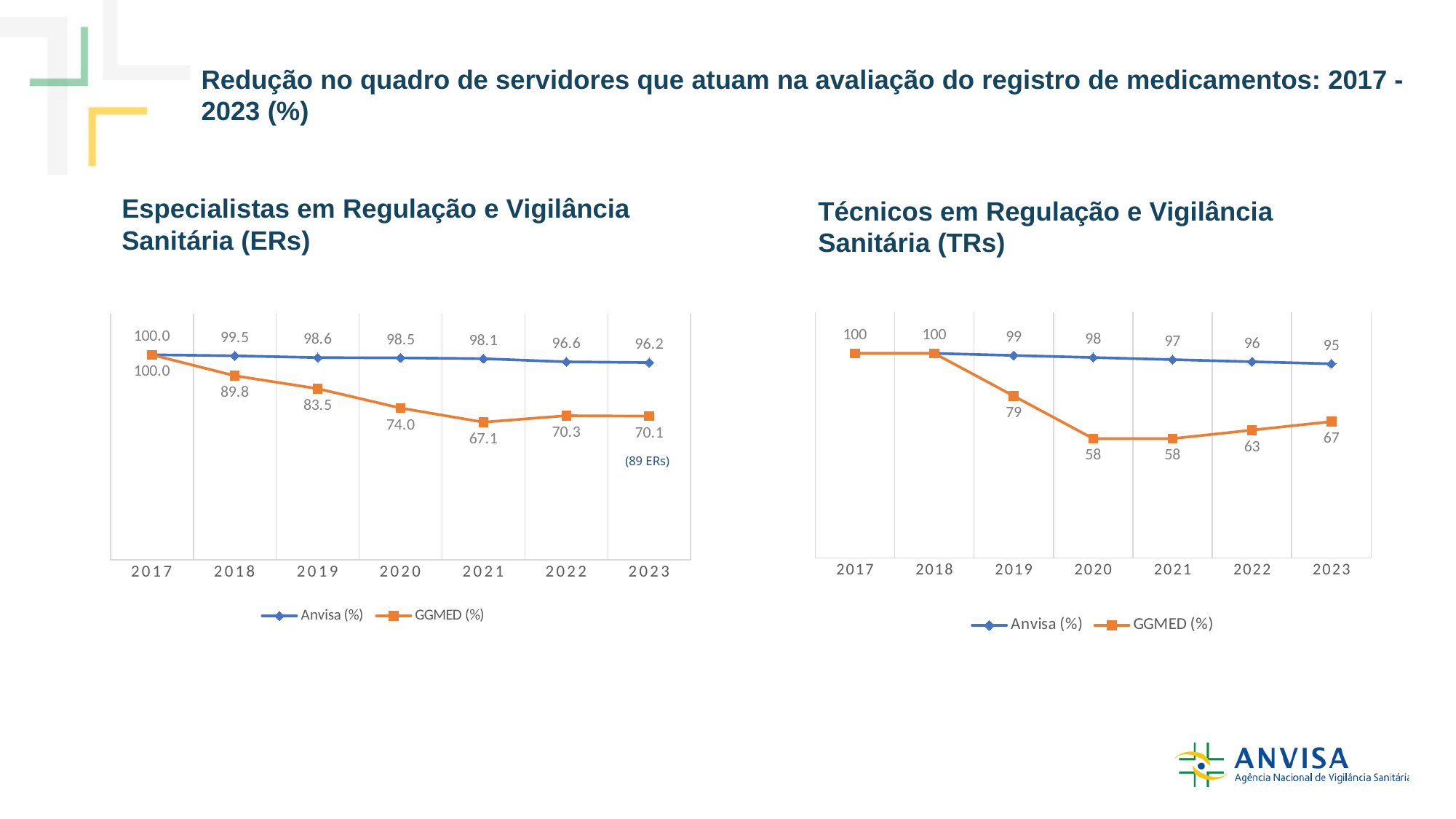
What kind of chart is the left chart (ERs)? Line chart In the right chart (Técnicos em Regulação e Vigilância Sanitária (TRs)), what is the GGMED (%) value for 2019? 79 In the left chart (ERs), what is the Anvisa (%) value for 2023? 96.2 In the right chart (TRs), what is the Anvisa (%) value for 2022? 96 In the right chart (TRs), which is larger in 2021: the Anvisa (%) value or the GGMED (%) value? Anvisa (%) In the right chart (TRs), what is the lowest GGMED (%) value shown? 58 In the left chart (ERs), what is the difference between the Anvisa (%) and GGMED (%) values in 2020? 24.5 How many series does the legend of the right chart (TRs) list? 2 In the left chart (Especialistas em Regulação e Vigilância Sanitária (ERs)), what is the GGMED (%) value for 2021? 67.1 In the left chart (ERs), which year has the lowest GGMED (%) value? 2021 In the right chart (TRs), what is the difference between the GGMED (%) values for 2018 and 2023? 33 How many years are plotted on the x axis of the left chart (ERs)? 7